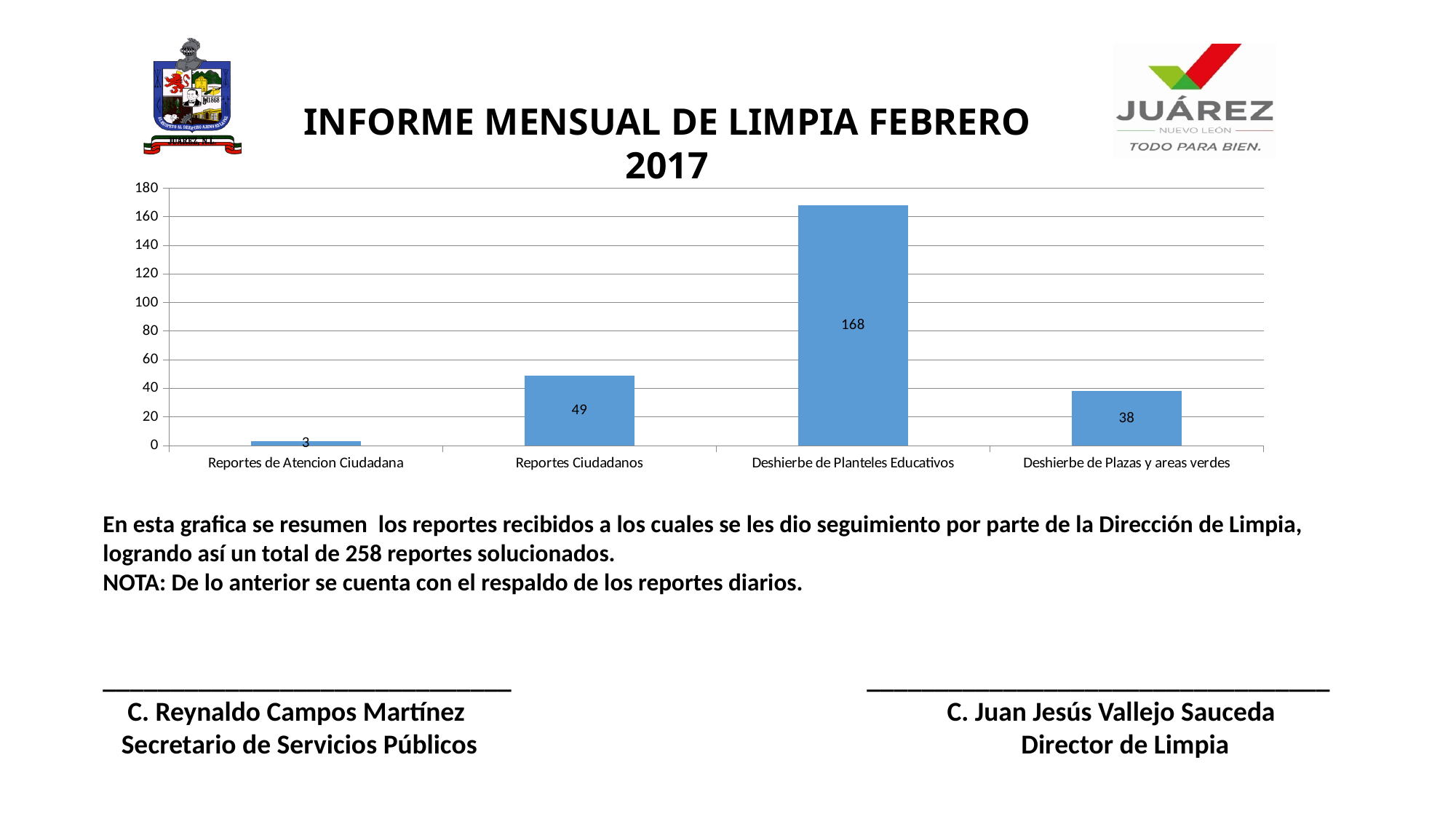
What is the maximum value shown on the vertical axis? 180 Which category has the highest value? Deshierbe de Planteles Educativos What is the difference between the values for Deshierbe de Planteles Educativos and Reportes Ciudadanos? 119 What kind of chart is shown on the slide? bar chart How many categories are shown on the x axis? 4 What is the value for Deshierbe de Plazas y areas verdes? 38 What is the value for Deshierbe de Planteles Educativos? 168 What is the value for Reportes de Atencion Ciudadana? 3 Is the value for Deshierbe de Planteles Educativos greater or less than 160? greater Which category has the lowest value? Reportes de Atencion Ciudadana Which is larger, the value for Reportes Ciudadanos or the value for Deshierbe de Plazas y areas verdes? Reportes Ciudadanos What is the value for Reportes Ciudadanos? 49